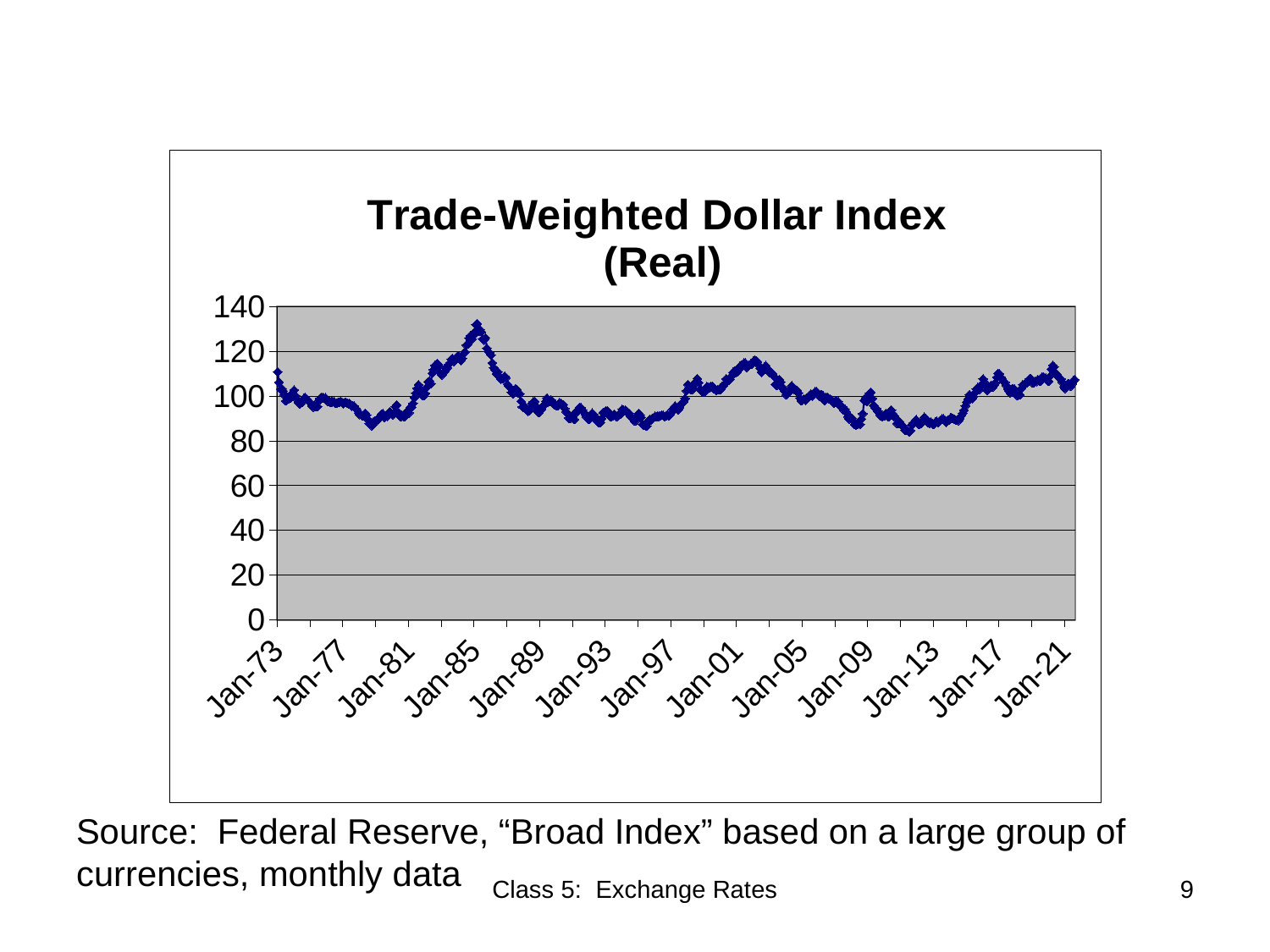
Is the value of the index at its peak near Jan-85 greater or less than 120? greater What is the title of the chart? Trade-Weighted Dollar Index (Real) Is the value of the index at Jan-13 greater or less than 100? less What kind of chart is shown on the slide? line chart How many labels are shown on the x axis of the chart? 13 Does the index rise or fall between Jan-85 and Jan-89? fall Is the value of the index at Jan-97 greater or less than 100? less Does the index rise or fall between Jan-81 and Jan-85? rise Around which x-axis label does the Trade-Weighted Dollar Index reach its highest point? Jan-85 What is the highest value shown on the y axis of the chart? 140